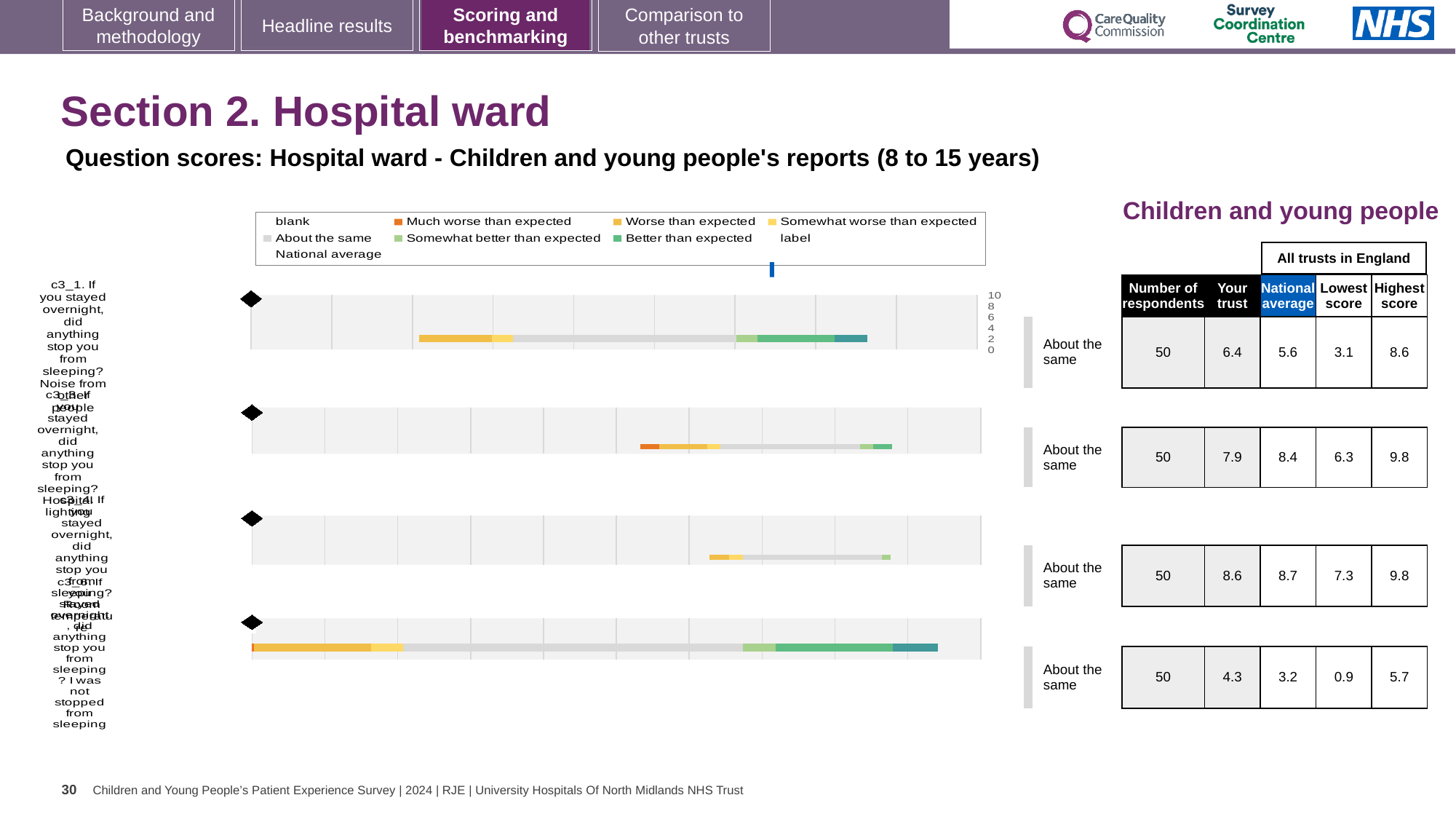
For the second question (c3_3), which is larger: the 'Your trust' score or the national average? National average (8.4) What colour does the legend use for 'Much worse than expected'? Orange For the first question (c3_1), what is the difference between the highest score and the lowest score across all trusts in England? 5.5 What kind of chart is used to show the question scores on this slide? bar chart How many questions (bars) are plotted in the chart? 4 What benchmark category is shown next to each of the four bars? About the same In the table beside the chart, what is the national average for the second question (c3_3, hospital lighting)? 8.4 In the table beside the chart, what is the number of respondents for the first question (c3_1, noise from other people)? 50 In the table beside the chart, what is the 'Your trust' score for the fourth question (c3_6, I was not stopped from sleeping)? 4.3 Which of the four questions has the highest 'Your trust' score in the table? The third question (c3_4), 8.6 Which of the four questions has the lowest 'Your trust' score in the table? The fourth question (c3_6), 4.3 For the first question (c3_1), which is larger: the 'Your trust' score or the national average? Your trust (6.4)